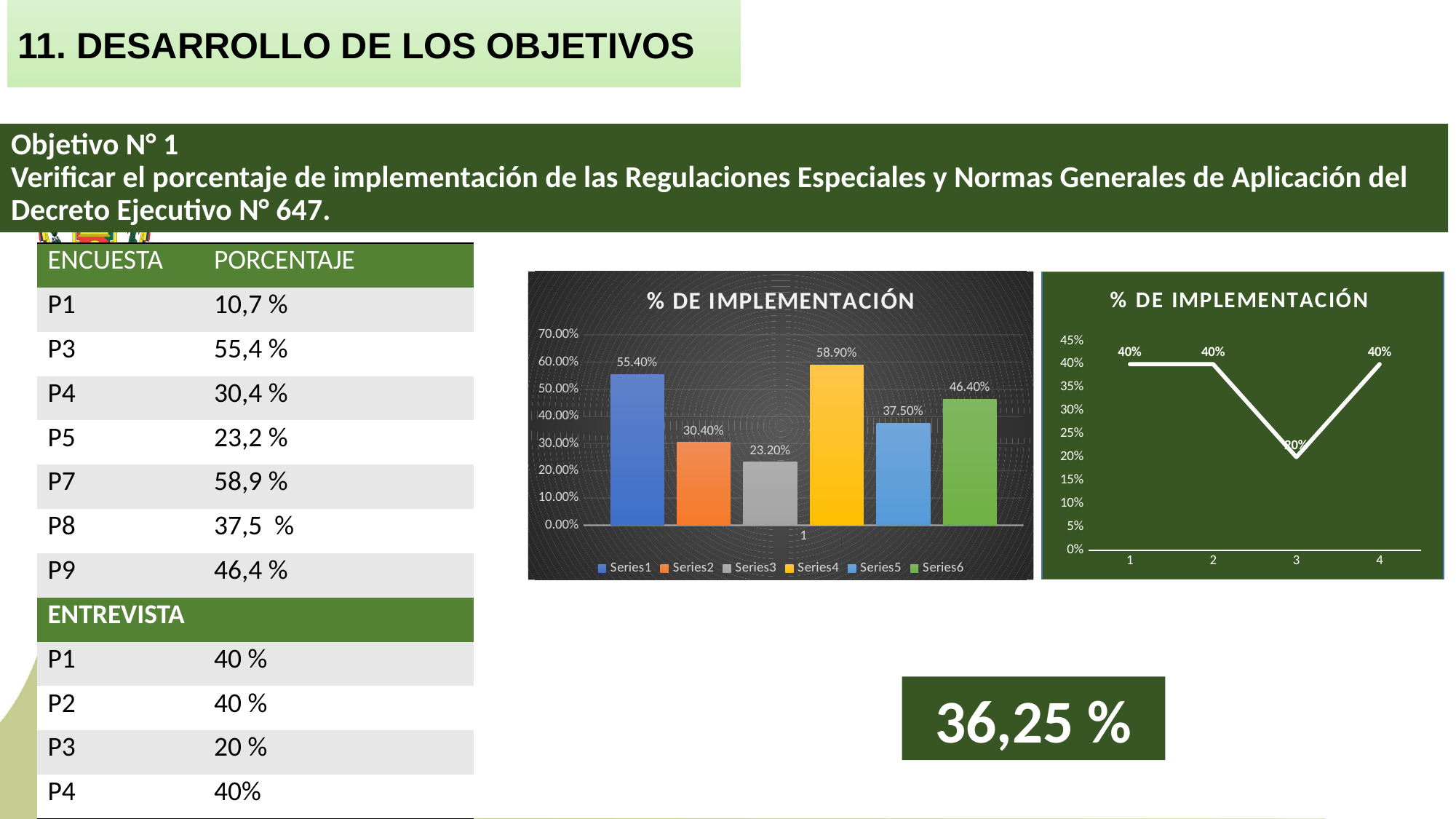
In the bar chart on the left, which is larger: Series5 or Series6? Series6 How many points are plotted in the line chart on the right? 4 In the bar chart on the left, is the value for Series6 greater or less than 40.00%? greater What is the title of the bar chart on the left? % DE IMPLEMENTACIÓN In the bar chart on the left, what is the value for Series4? 58.90% What kind of chart is the chart on the right of the slide? line chart What kind of chart is the chart on the left of the slide? bar chart In the bar chart on the left, what is the difference between the values for Series1 and Series2? 25.00% In the bar chart on the left, which series has the lowest value? Series3 In the line chart on the right, what is the value at point 3? 20% In the bar chart on the left, which series has the highest value? Series4 How many series does the legend of the bar chart on the left list? 6